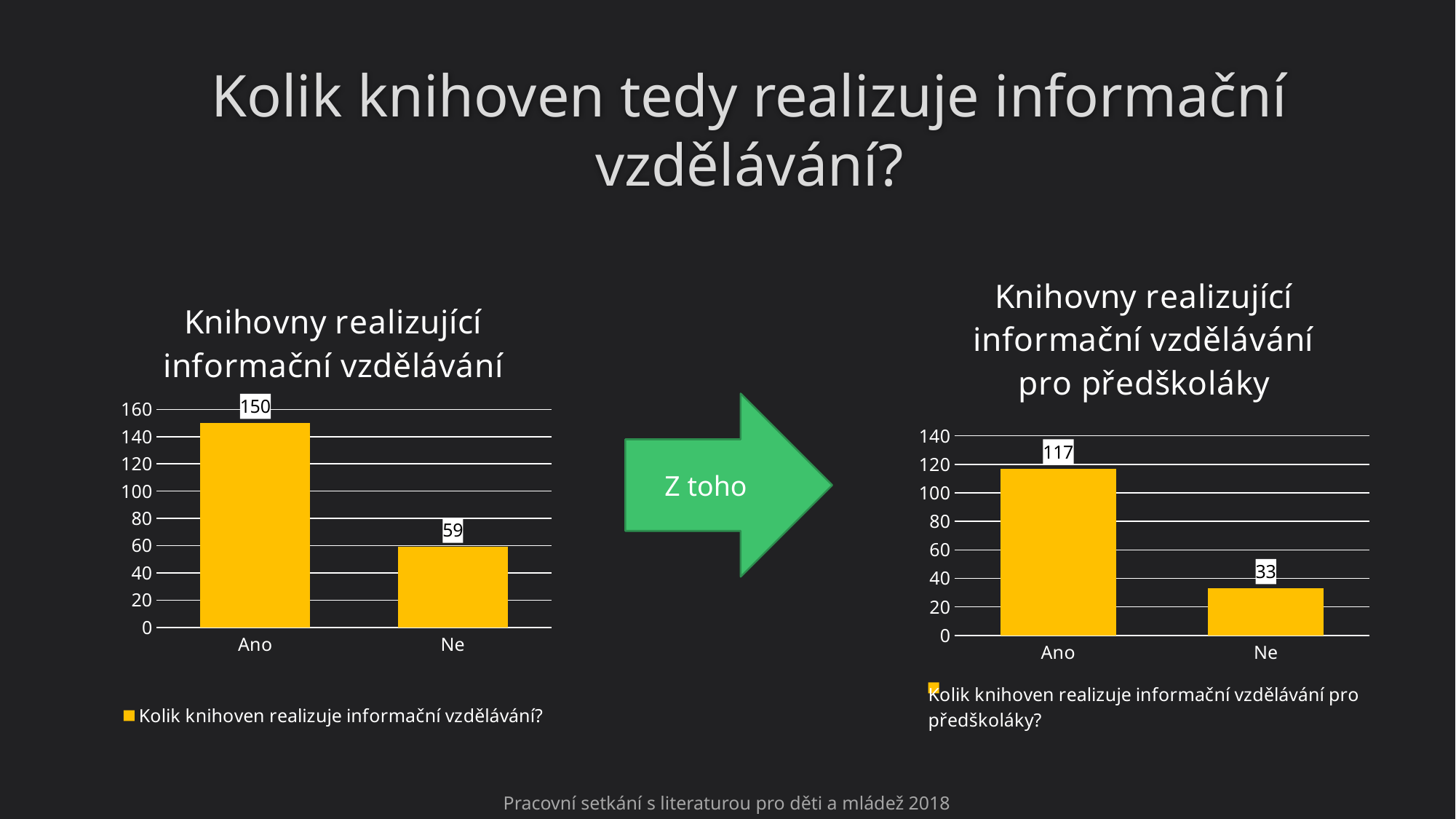
In the right chart 'Knihovny realizující informační vzdělávání pro předškoláky', what is the value for Ano? 117 In the left chart 'Knihovny realizující informační vzdělávání', what is the value for Ne? 59 What kind of chart is the left chart? Bar chart In the right chart 'Knihovny realizující informační vzdělávání pro předškoláky', what is the value for Ne? 33 What is the legend entry of the left chart? Kolik knihoven realizuje informační vzdělávání? In the right chart, what is the difference between the values for Ano and Ne? 84 In the left chart, what is the difference between the values for Ano and Ne? 91 How many categories does the right chart show? 2 Which is larger: the value for Ano in the left chart or the value for Ano in the right chart? Ano in the left chart In the left chart, which category has the highest value? Ano In the left chart 'Knihovny realizující informační vzdělávání', what is the value for Ano? 150 In the right chart, which category has the lowest value? Ne